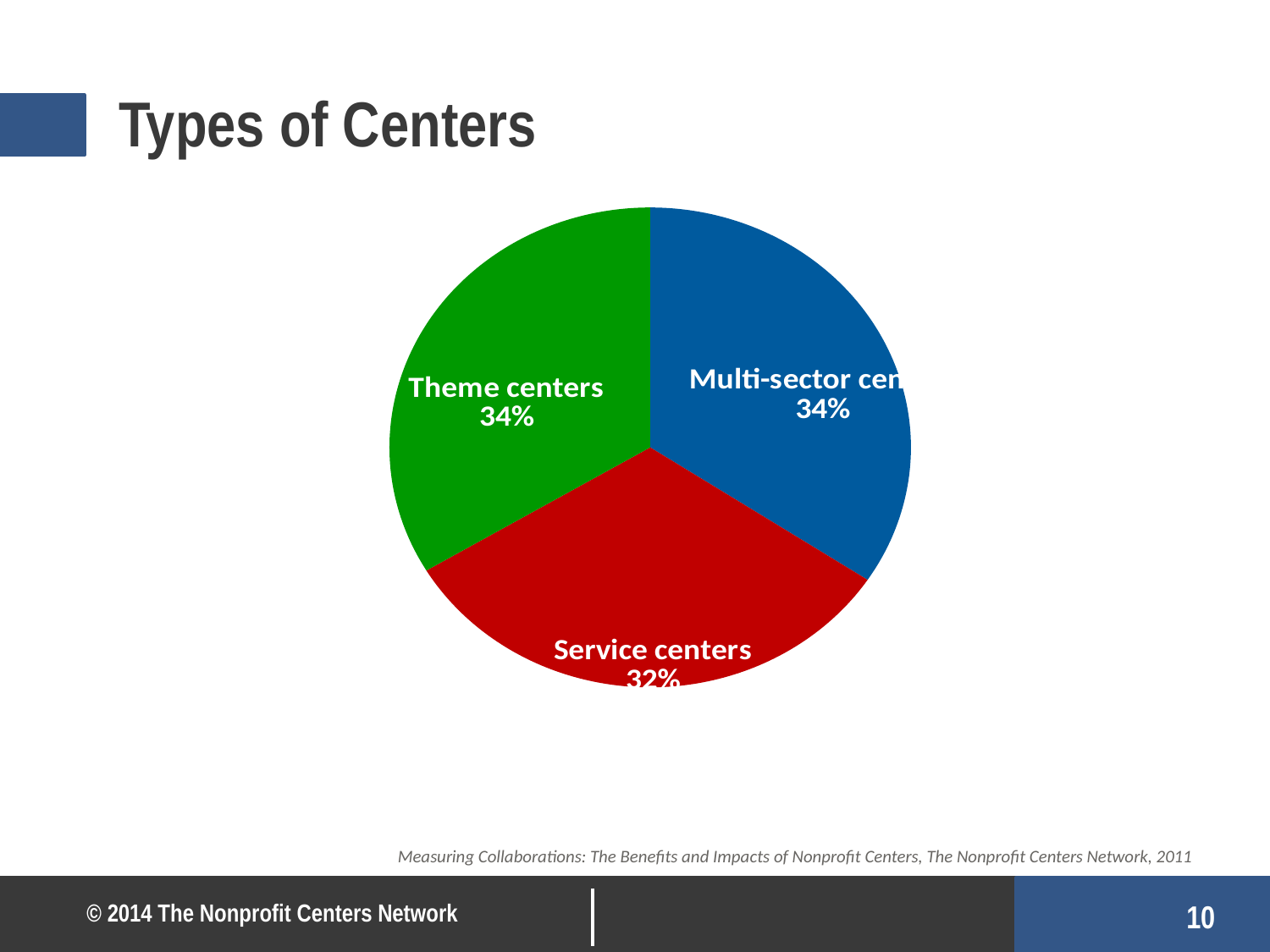
Is the share for Service centers greater or less than 34%? less What colour is the Service centers slice? red Do the Theme centers and Multi-sector centers slices show the same percentage? yes Which type of center has the smallest share of the pie? Service centers What share of the pie do Service centers represent? 32% What kind of chart is shown on the slide? pie chart What is the title of the slide containing the pie chart? Types of Centers How many slices does the pie chart have? 3 What percentage is shown for the blue Multi-sector centers slice? 34% Which is larger, the share for Theme centers or the share for Service centers? Theme centers What is the difference between the Theme centers share and the Service centers share? 2% What share of the pie do Theme centers represent? 34%